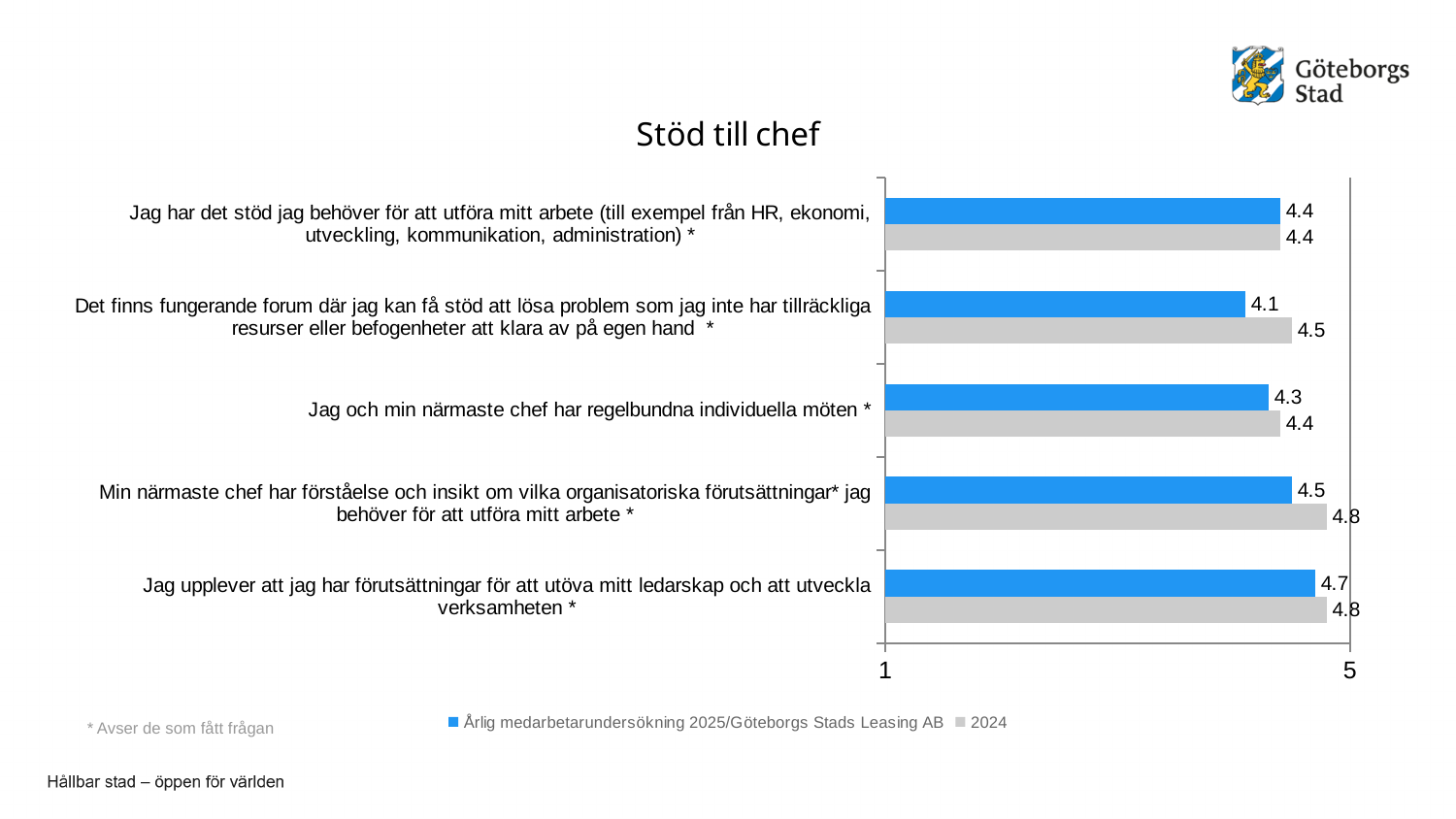
What is the title of the chart? Stöd till chef For "Min närmaste chef har förståelse och insikt om vilka organisatoriska förutsättningar jag behöver för att utföra mitt arbete", which is larger: the 2025 value or the 2024 value? 2024 What type of chart is shown on the slide? bar chart How many statements (categories) are shown in the chart? 5 What is the difference between the 2024 and 2025 values for "Det finns fungerande forum där jag kan få stöd att lösa problem som jag inte har tillräckliga resurser eller befogenheter att klara av på egen hand"? 0.4 Which statement has the lowest 2025 value? Det finns fungerande forum där jag kan få stöd att lösa problem som jag inte har tillräckliga resurser eller befogenheter att klara av på egen hand What is the 2025 value for "Jag upplever att jag har förutsättningar för att utöva mitt ledarskap och att utveckla verksamheten"? 4.7 Which statement has the highest 2025 value? Jag upplever att jag har förutsättningar för att utöva mitt ledarskap och att utveckla verksamheten What is the 2024 value for "Det finns fungerande forum där jag kan få stöd att lösa problem som jag inte har tillräckliga resurser eller befogenheter att klara av på egen hand"? 4.5 What is the 2024 value for "Min närmaste chef har förståelse och insikt om vilka organisatoriska förutsättningar jag behöver för att utföra mitt arbete"? 4.8 What is the 2025 value for "Jag och min närmaste chef har regelbundna individuella möten"? 4.3 How many series does the legend list? 2